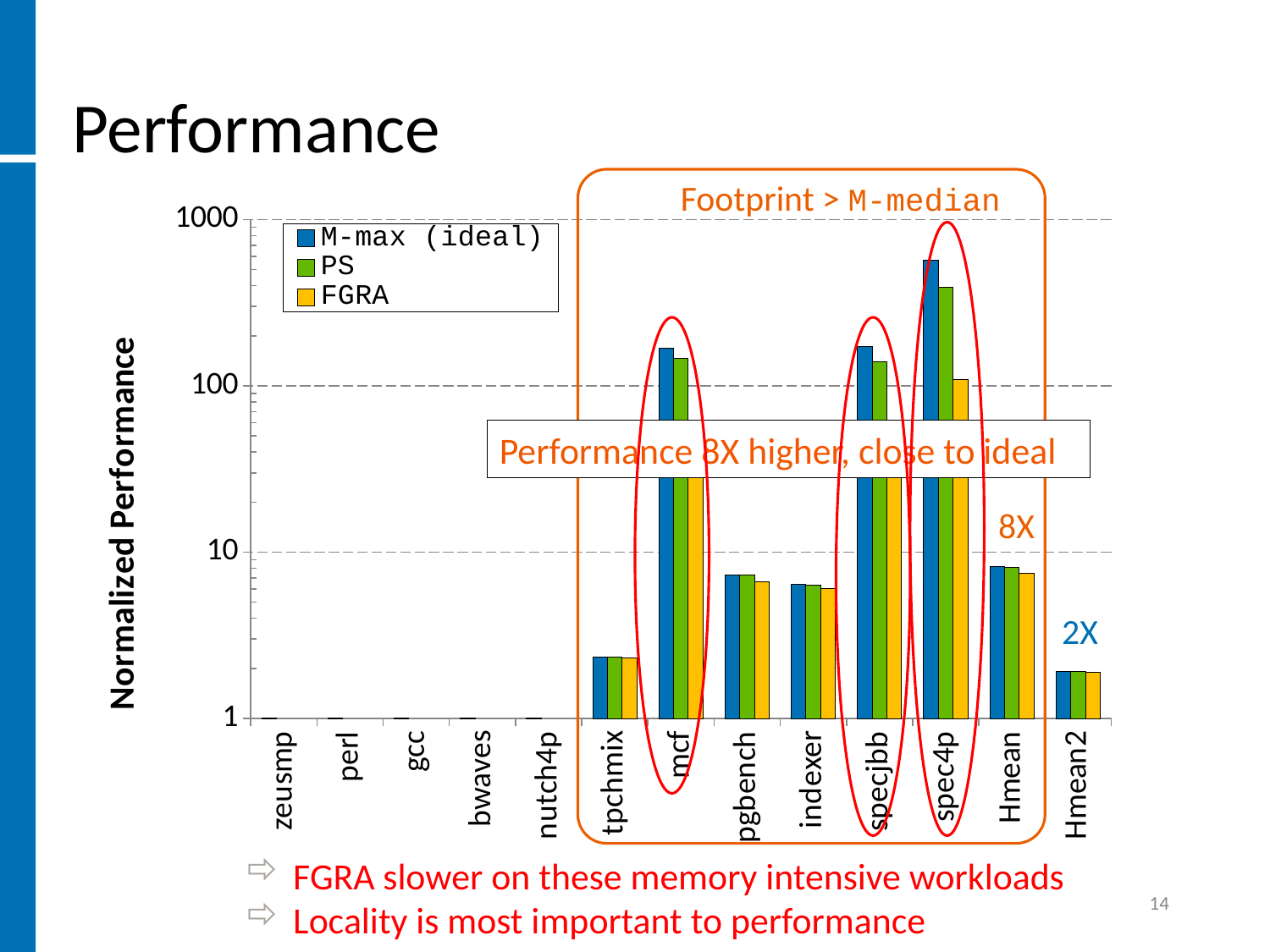
Is the FGRA value for specjbb greater or less than 100? less Is the M-max (ideal) value for mcf greater or less than 100? greater Is the FGRA value for Hmean2 greater or less than 10? less Which is larger, the FGRA value for spec4p or the FGRA value for Hmean? spec4p How many series does the legend list? 3 Which category has the highest M-max (ideal) value? spec4p What kind of chart is shown on the slide? bar chart Which is larger, the M-max (ideal) value for spec4p or the M-max (ideal) value for mcf? spec4p What is the label of the y axis? Normalized Performance How many categories are shown along the x axis? 13